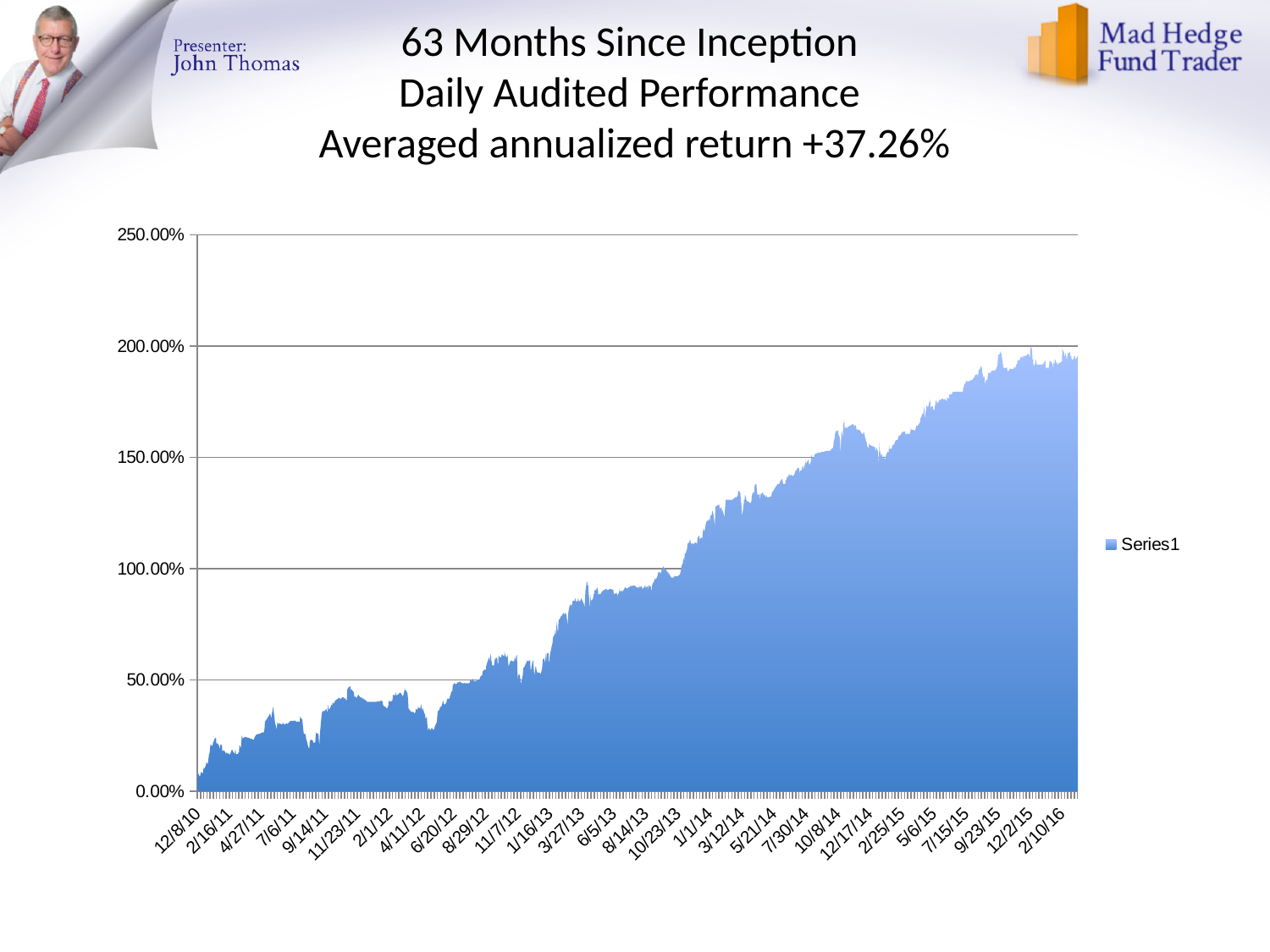
Which is larger, the value at 9/14/11 or the value at 9/23/15? 9/23/15 Do the values generally rise or fall from 12/8/10 to 2/10/16? rise What kind of chart is shown on the slide? area chart Is the value at 7/15/15 greater or less than 150.00%? greater What averaged annualized return is stated in the slide title? +37.26% What is the name of the series shown in the legend? Series1 Is the value at 12/8/10 greater or less than 50.00%? less Is the value at 2/10/16 greater or less than 150.00%? greater How many series does the legend list? 1